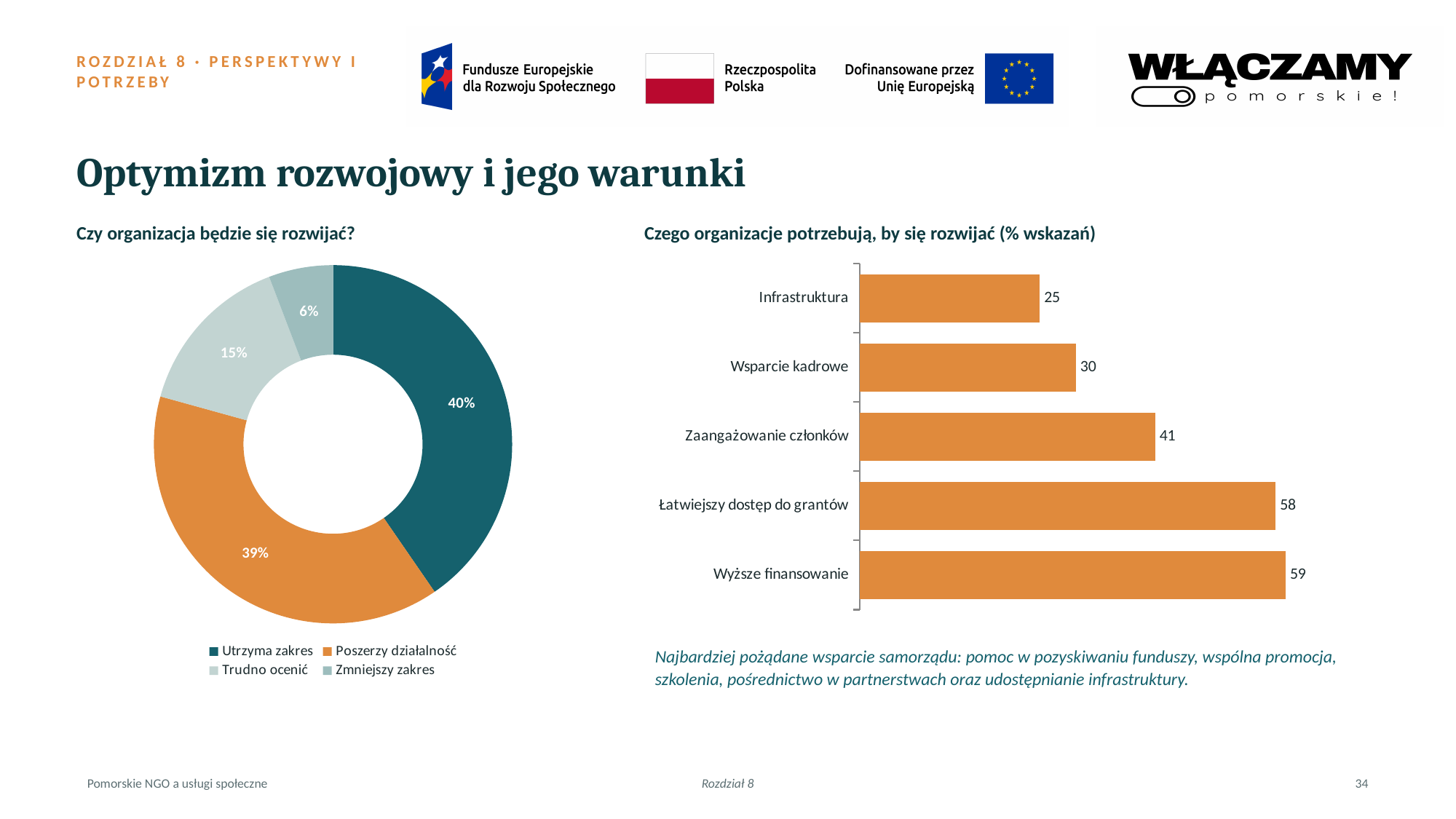
In the chart 'Czy organizacja będzie się rozwijać?', what share of organizations answered 'Trudno ocenić'? 15% In the chart 'Czego organizacje potrzebują, by się rozwijać (% wskazań)', which category has the lowest value? Infrastruktura In the chart 'Czego organizacje potrzebują, by się rozwijać (% wskazań)', which is larger: 'Zaangażowanie członków' or 'Wsparcie kadrowe'? Zaangażowanie członków In the chart 'Czego organizacje potrzebują, by się rozwijać (% wskazań)', what is the value for 'Zaangażowanie członków'? 41 How many categories are shown in the chart 'Czego organizacje potrzebują, by się rozwijać (% wskazań)'? 5 What kind of chart is 'Czego organizacje potrzebują, by się rozwijać (% wskazań)'? Bar chart In the chart 'Czy organizacja będzie się rozwijać?', which answer has the smallest share? Zmniejszy zakres What kind of chart is 'Czy organizacja będzie się rozwijać?'? Pie (donut) chart In the chart 'Czy organizacja będzie się rozwijać?', what share of organizations answered 'Utrzyma zakres'? 40% In the chart 'Czy organizacja będzie się rozwijać?', how many categories does the legend list? 4 In the chart 'Czego organizacje potrzebują, by się rozwijać (% wskazań)', what is the difference between 'Łatwiejszy dostęp do grantów' and 'Wsparcie kadrowe'? 28 In the chart 'Czego organizacje potrzebują, by się rozwijać (% wskazań)', what is the value for 'Infrastruktura'? 25